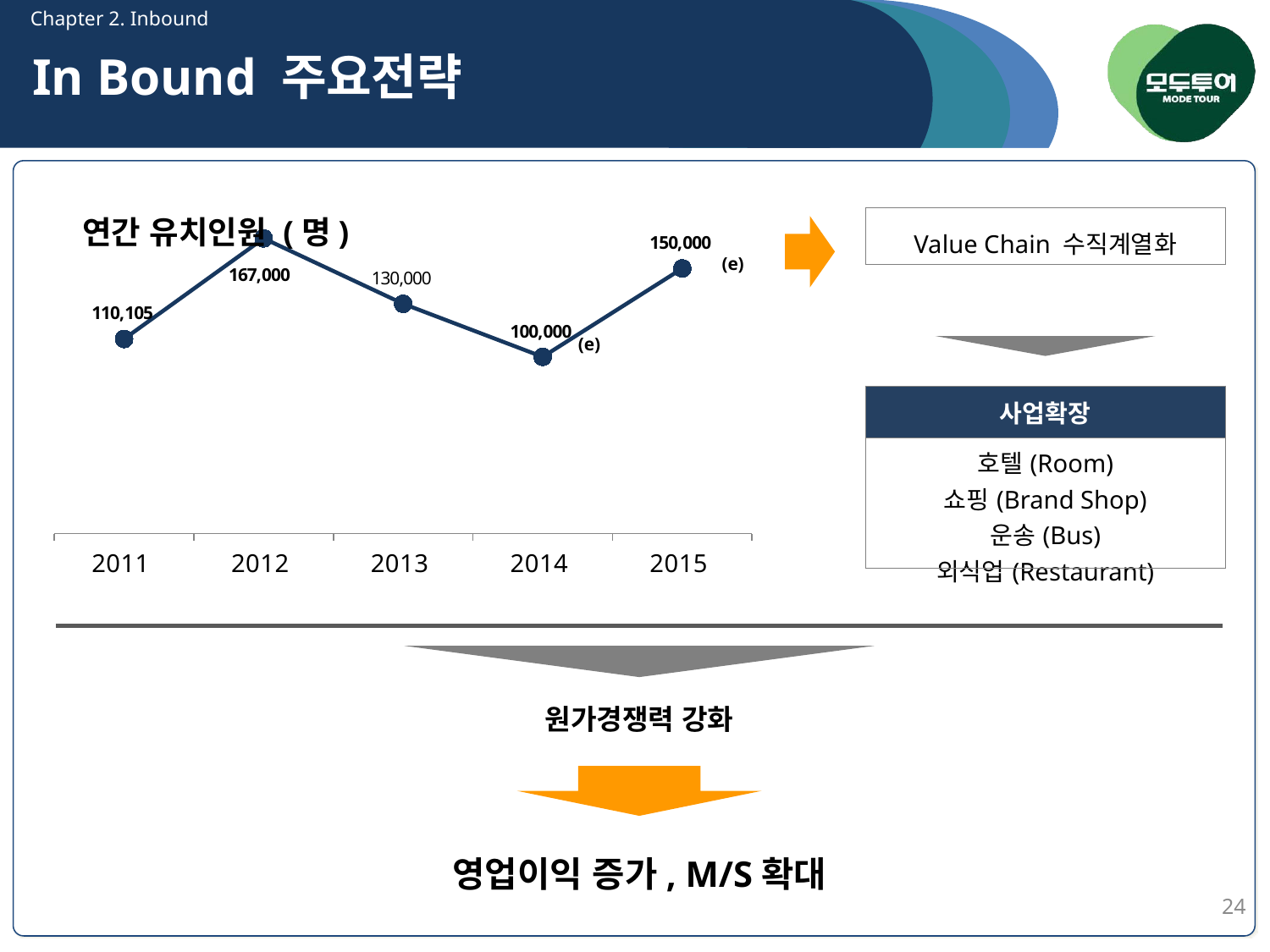
What is the difference between the 2012 and 2013 values in the line chart? 37,000 What is the value for 2013 in the line chart? 130,000 What is the value for 2014 in the line chart? 100,000 What kind of chart is shown on the slide? Line chart Which is larger in the line chart, the value for 2013 or the value for 2015? 2015 Which year has the highest value in the line chart? 2012 What is the value for 2011 in the line chart? 110,105 What is the value for 2015 in the line chart? 150,000 What is the title of the chart on the slide? 연간 유치인원 ( 명 ) How many years are plotted on the x axis of the line chart? 5 Which year has the lowest value in the line chart? 2014 What is the value for 2012 in the line chart? 167,000